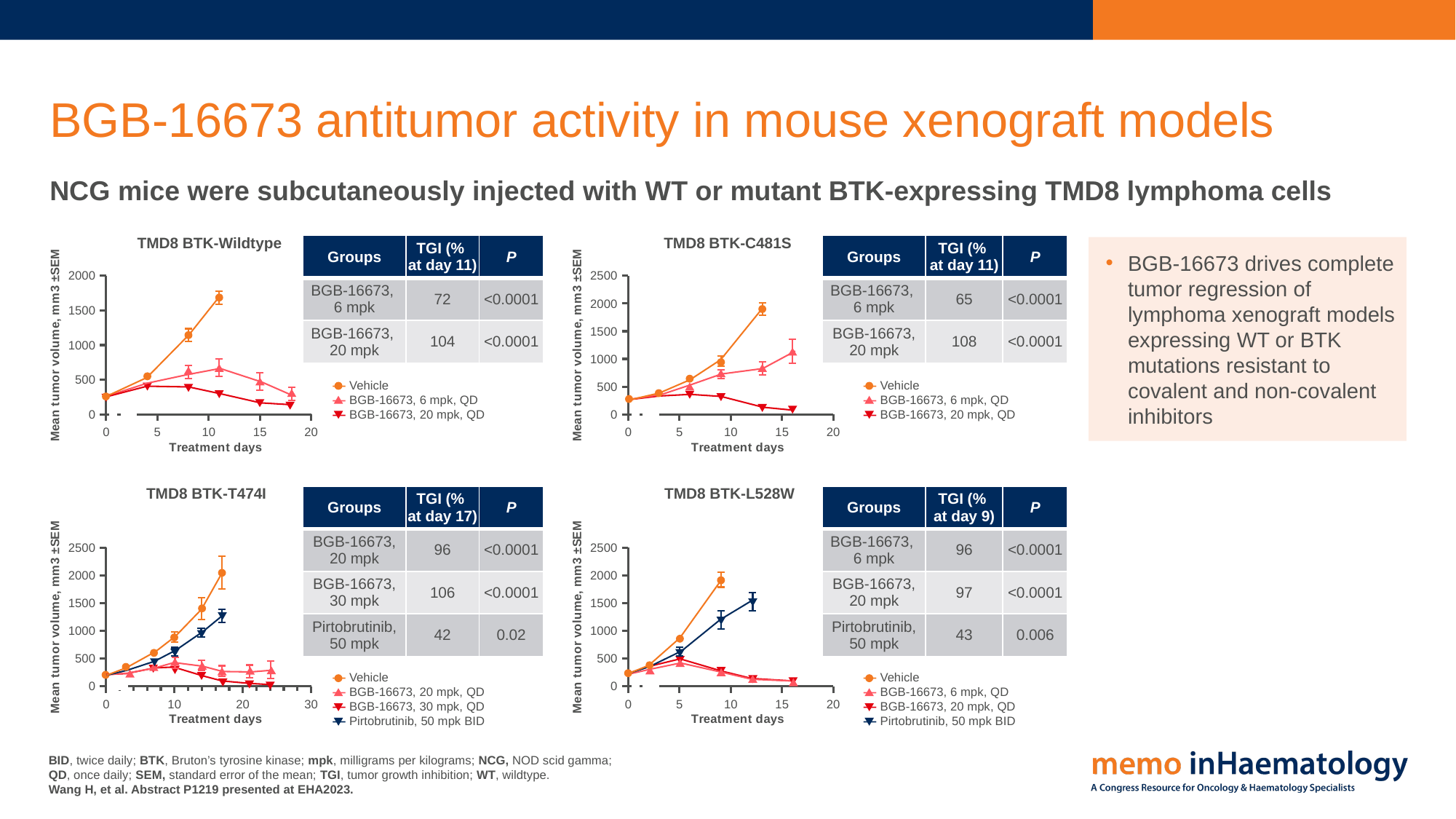
In the TMD8 BTK-L528W chart, is the BGB-16673, 20 mpk, QD value at day 16 greater or less than 500? less In the TMD8 BTK-L528W chart, is the Pirtobrutinib, 50 mpk BID value at day 12 greater or less than 1000? greater How many series does the legend of the TMD8 BTK-Wildtype chart list? 3 What is the x-axis label of the TMD8 BTK-C481S chart? Treatment days What kind of chart is the TMD8 BTK-Wildtype chart? Line chart In the TMD8 BTK-L528W chart, which series reaches the highest mean tumor volume? Vehicle In the TMD8 BTK-C481S chart, is the Vehicle value at day 13 greater or less than 1500? greater How many series does the legend of the TMD8 BTK-T474I chart list? 4 In the TMD8 BTK-Wildtype chart, does the BGB-16673, 20 mpk, QD series rise or fall between day 5 and day 18? Fall In the TMD8 BTK-T474I chart, at day 17, which is larger: the Vehicle value or the Pirtobrutinib, 50 mpk BID value? Vehicle